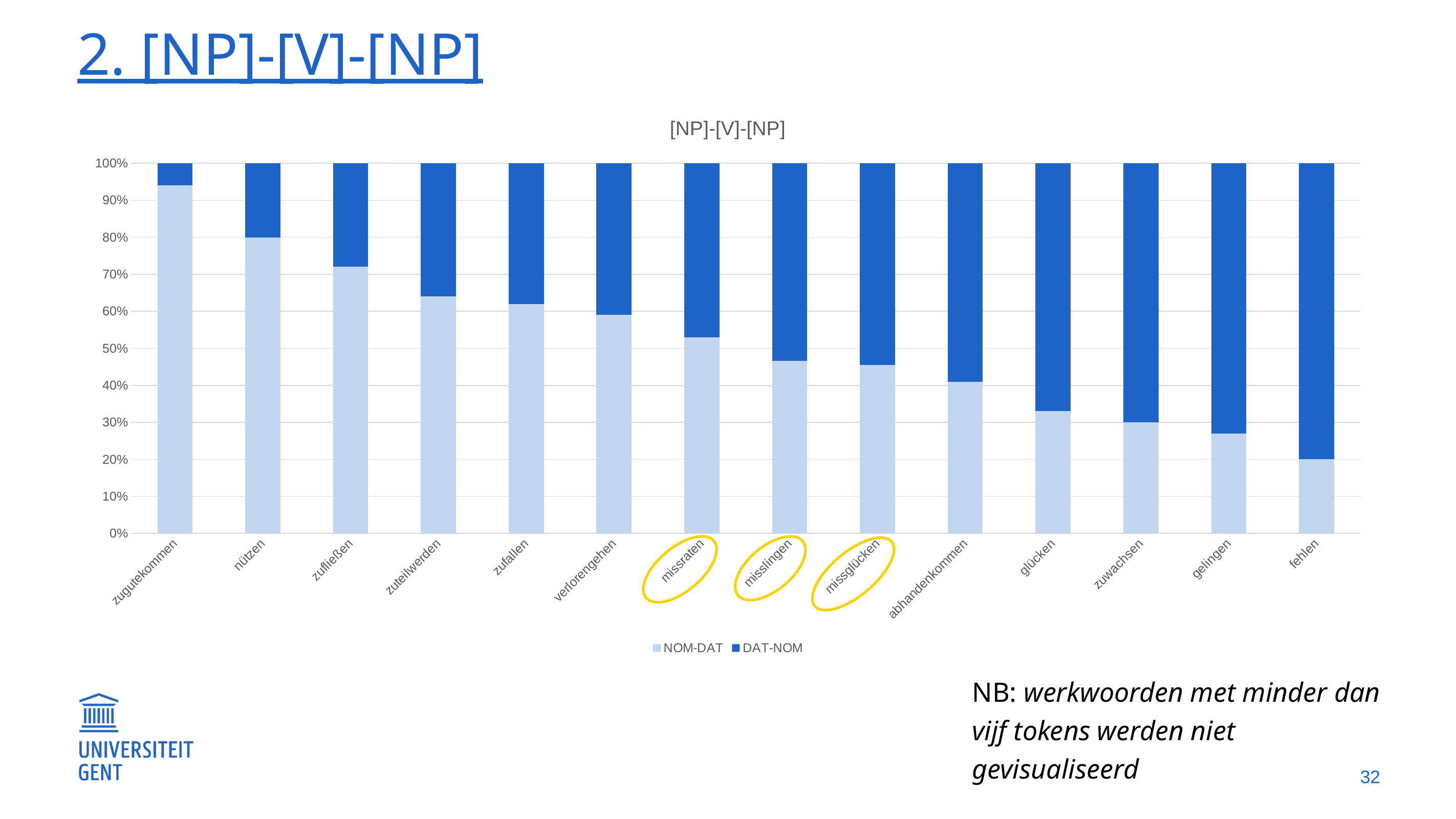
How many verbs (categories) are shown on the x axis of the chart? 14 What is the title of the chart? [NP]-[V]-[NP] Is the NOM-DAT share for abhandenkommen greater or less than 50%? less Which verb has the lowest NOM-DAT share? fehlen Which verb has a larger NOM-DAT share, nützen or glücken? nützen Does the NOM-DAT share rise or fall moving from left to right along the x axis? fall What kind of chart is shown on the slide? bar chart What are the two series named in the legend? NOM-DAT and DAT-NOM Which verb has the highest NOM-DAT share? zugutekommen How many series does the legend of the chart list? 2 Is the NOM-DAT share for zugutekommen greater or less than 90%? greater Is the NOM-DAT share for zufließen greater or less than 70%? greater